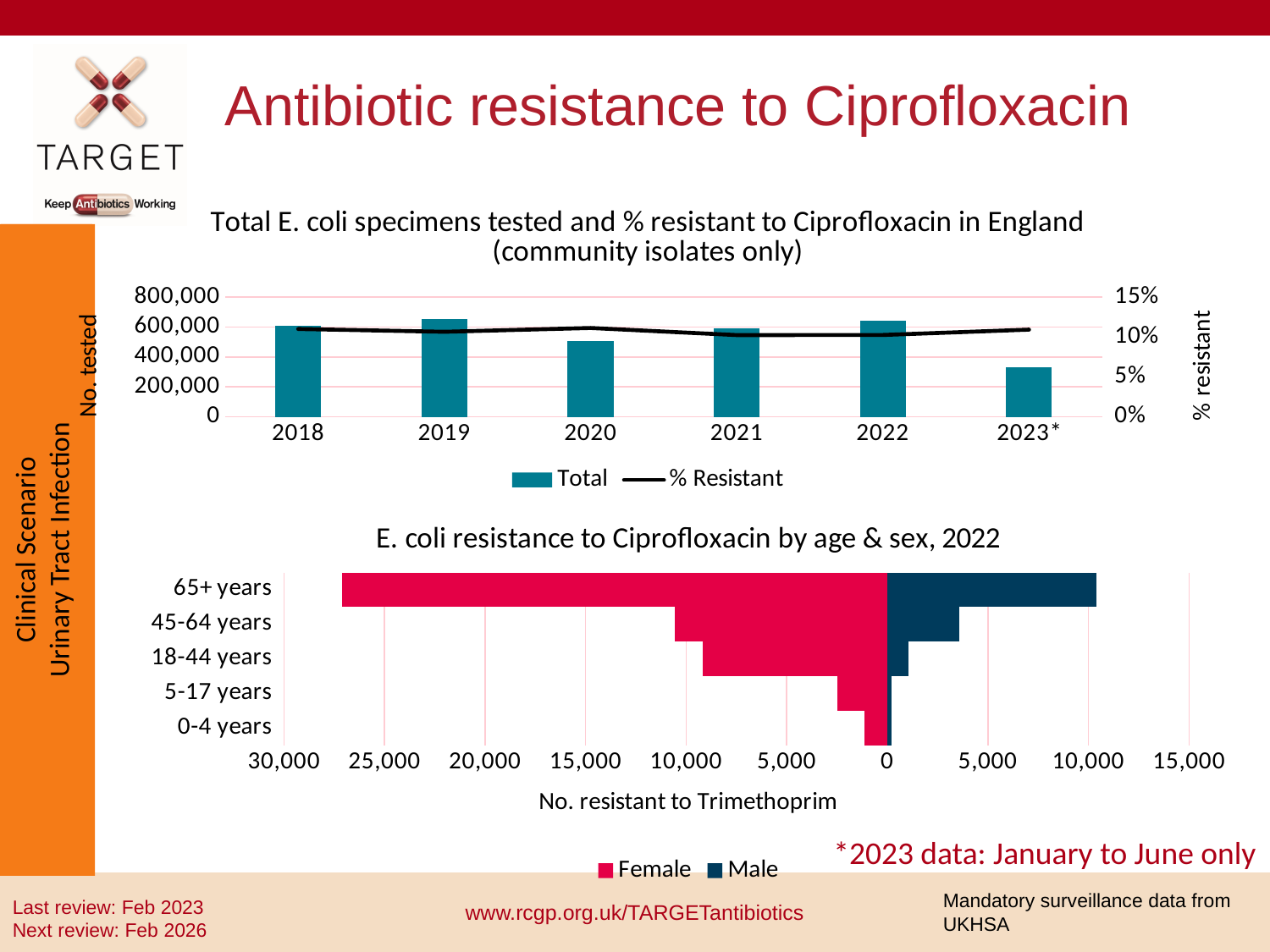
In the top chart, what is the label of the left vertical axis? No. tested In the top chart, which is larger, the Total for 2020 or the Total for 2023*? 2020 In the bottom chart, is the Male value for 65+ years greater or less than 10,000? greater In the top chart, how many series does the legend list? 2 In the top chart, what kind of chart is used to show the Total series? bar chart In the bottom chart, which age group has the highest number of resistant Female isolates? 65+ years In the bottom chart, how many age groups are shown? 5 In the bottom chart, which is larger for 65+ years, the Female value or the Male value? Female In the top chart, which year has the lowest Total number tested? 2023* In the top chart, is the Total for 2019 greater or less than 600,000? greater In the top chart, how many years are shown on the x axis? 6 In the top chart, is the Total for 2020 greater or less than 600,000? less